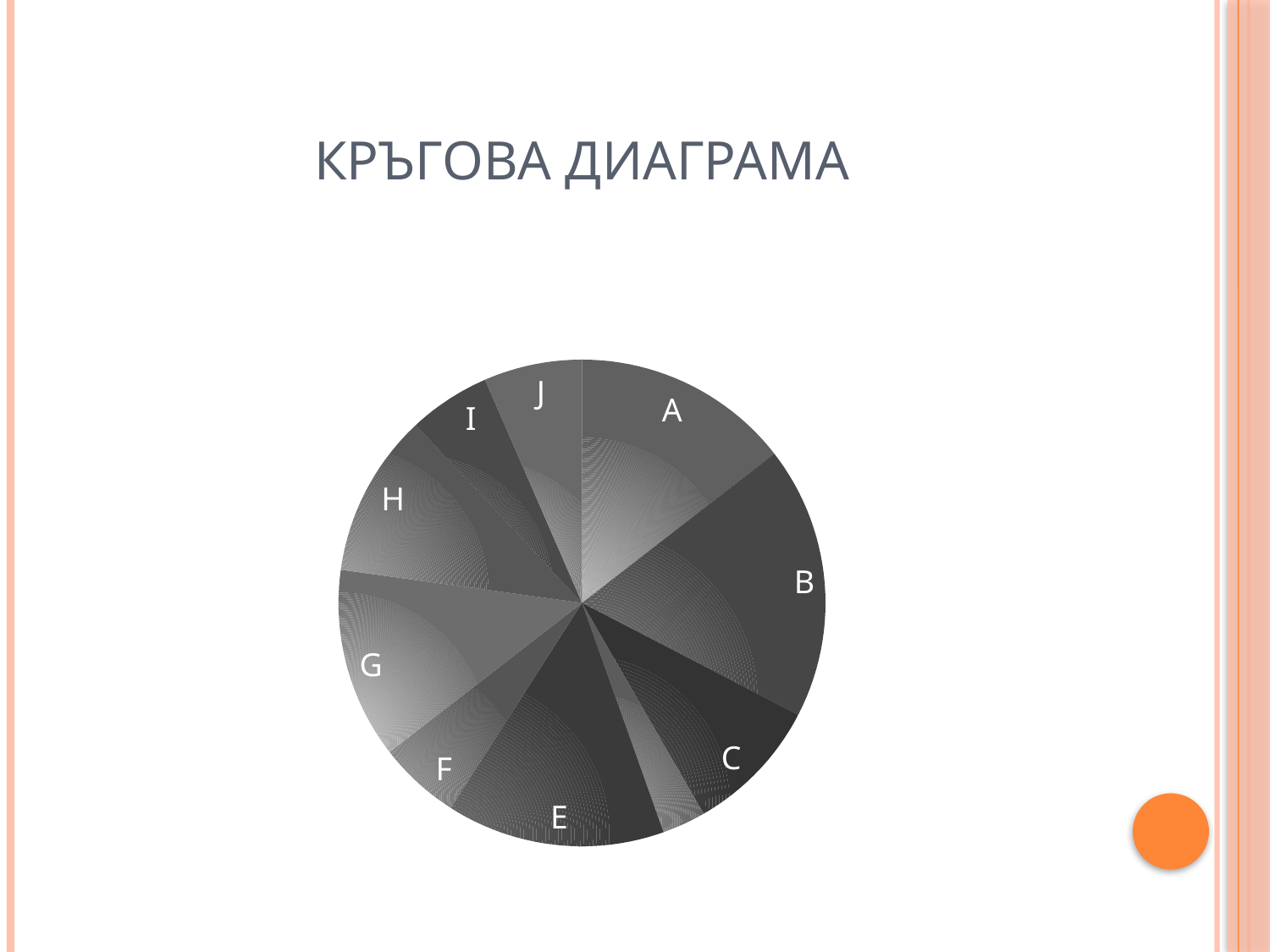
Which slice is larger, H or I? H Which slice is larger, E or F? E Which slice is larger, E or J? E What kind of chart is shown on the slide? pie chart Does the pie chart display a legend? No What is the title of the slide with the pie chart? КРЪГОВА ДИАГРАМА Which labelled slice of the pie chart is the largest? B